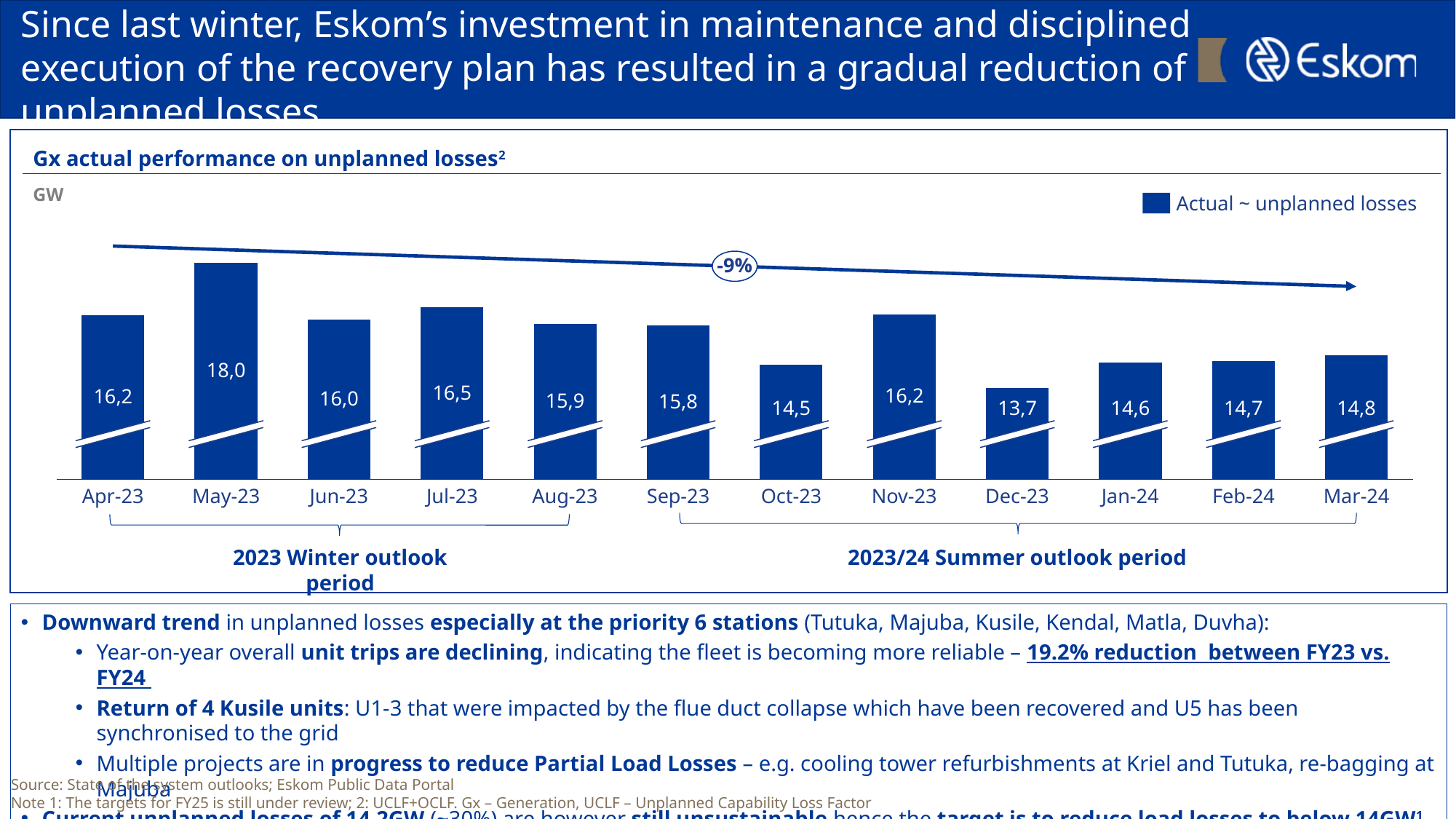
How many series does the legend list? 1 What is the value of unplanned losses for Mar-24? 14,8 What is the difference in unplanned losses between Apr-23 and Mar-24? 1,4 Which month has the lowest unplanned losses? Dec-23 Which month has the highest unplanned losses? May-23 How many months are plotted on the chart? 12 What type of chart is shown on the slide? bar chart What is the value of unplanned losses for May-23? 18,0 What is the difference in unplanned losses between May-23 and Dec-23? 4,3 What is the value of unplanned losses for Dec-23? 13,7 Which month has higher unplanned losses, Jul-23 or Oct-23? Jul-23 What unit is shown on the chart's axis label? GW